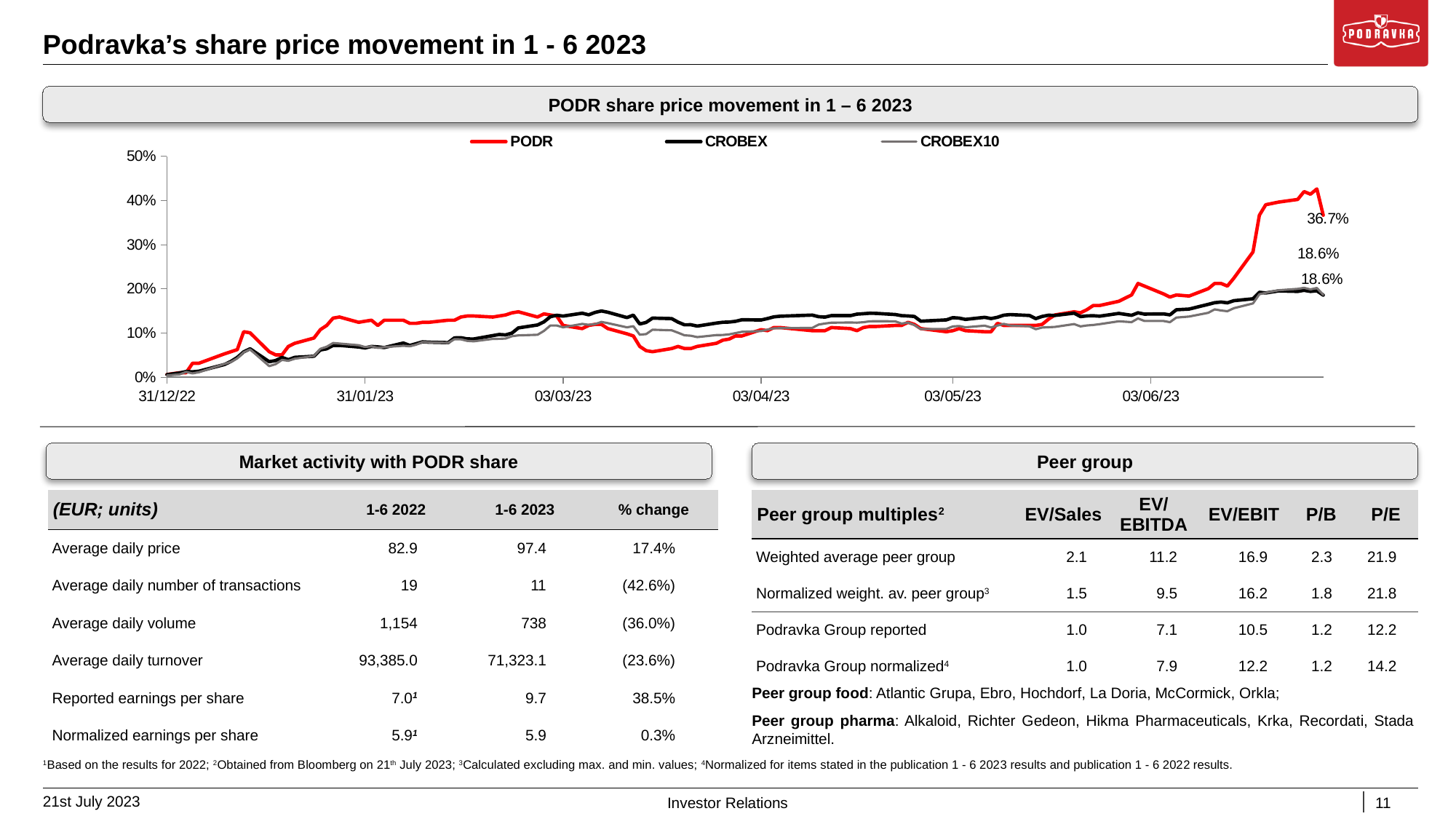
What is the difference between the final PODR value (36.7%) and the final CROBEX value (18.6%)? 18.1 percentage points At the end of the chart, which is larger: the PODR value or the CROBEX value? PODR What colour is the PODR line on the share price movement chart? Red What is the final value labelled for the CROBEX line at the end of the chart? 18.6% What kind of chart is shown under the title "PODR share price movement in 1 – 6 2023"? Line chart How many series does the legend of the share price movement chart list? 3 Is the final value of the CROBEX10 line greater or less than 20%? less Which series ends at the highest value on the share price movement chart? PODR Does the PODR line rise or fall overall from 31/12/22 to the end of the chart? Rise What is the final value labelled for the PODR line at the end of the chart? 36.7% Is the final value of the PODR line greater or less than 30%? greater Which series are listed in the legend of the share price movement chart? PODR, CROBEX, CROBEX10